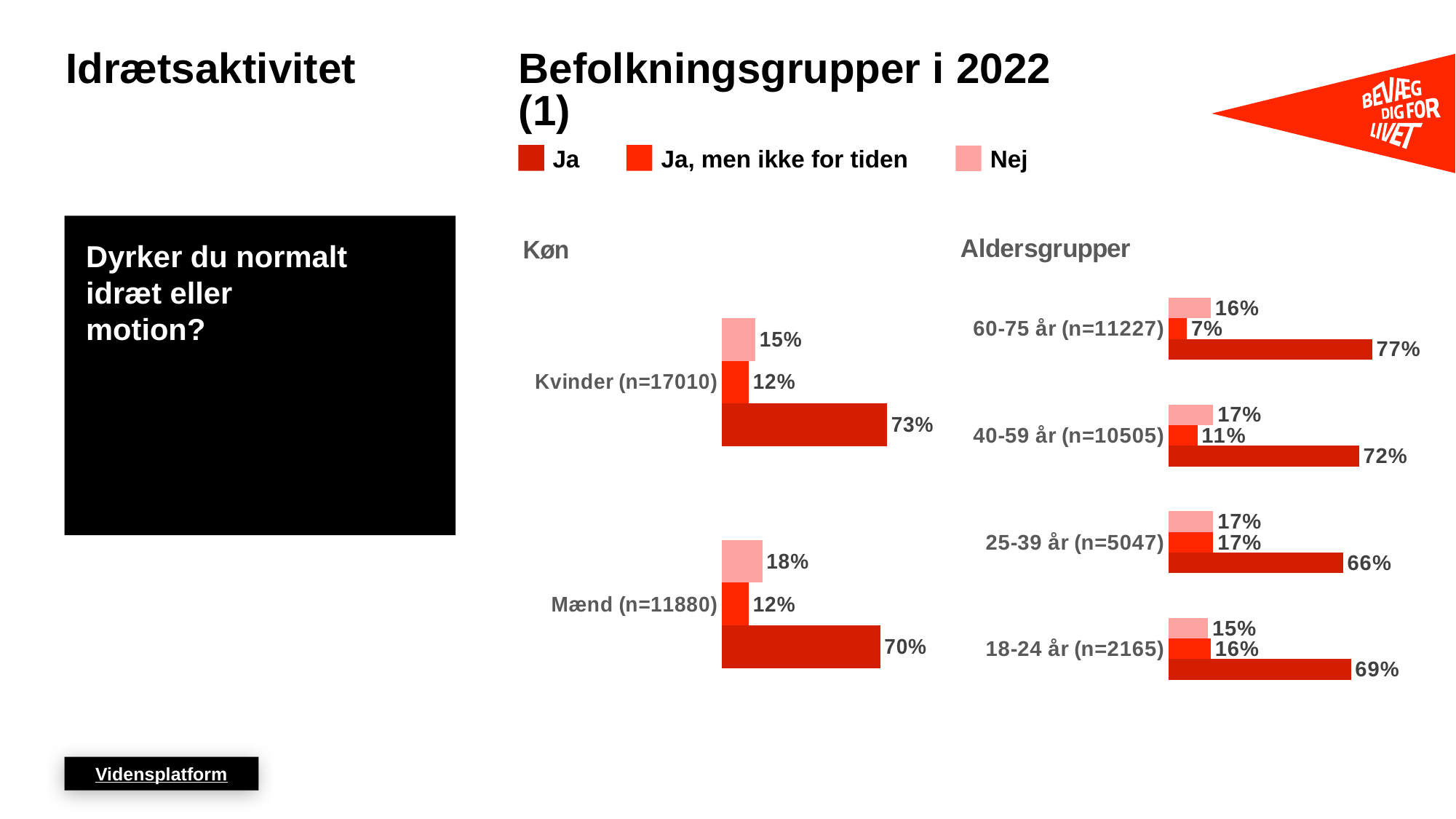
In the Aldersgrupper chart, which age group has the highest Ja percentage? 60-75 år (n=11227) In the Køn chart, what percentage of Kvinder (n=17010) answered Ja? 73% In the Aldersgrupper chart, what percentage of the 60-75 år group answered Ja, men ikke for tiden? 7% How many series does the legend list? 3 What kind of chart is the Køn chart? Bar chart In the Køn chart, what is the difference between the Ja percentage for Kvinder and for Mænd? 3 percentage points In the Aldersgrupper chart, which is larger: the Ja percentage for 18-24 år or for 40-59 år? 40-59 år In the Aldersgrupper chart, what percentage of the 25-39 år group answered Ja? 66% In the Aldersgrupper chart, which age group has the lowest Ja percentage? 25-39 år (n=5047) In the Køn chart, what percentage of Mænd (n=11880) answered Nej? 18% Which legend entry is shown in the lightest (pink) colour? Nej How many age groups are shown in the Aldersgrupper chart? 4